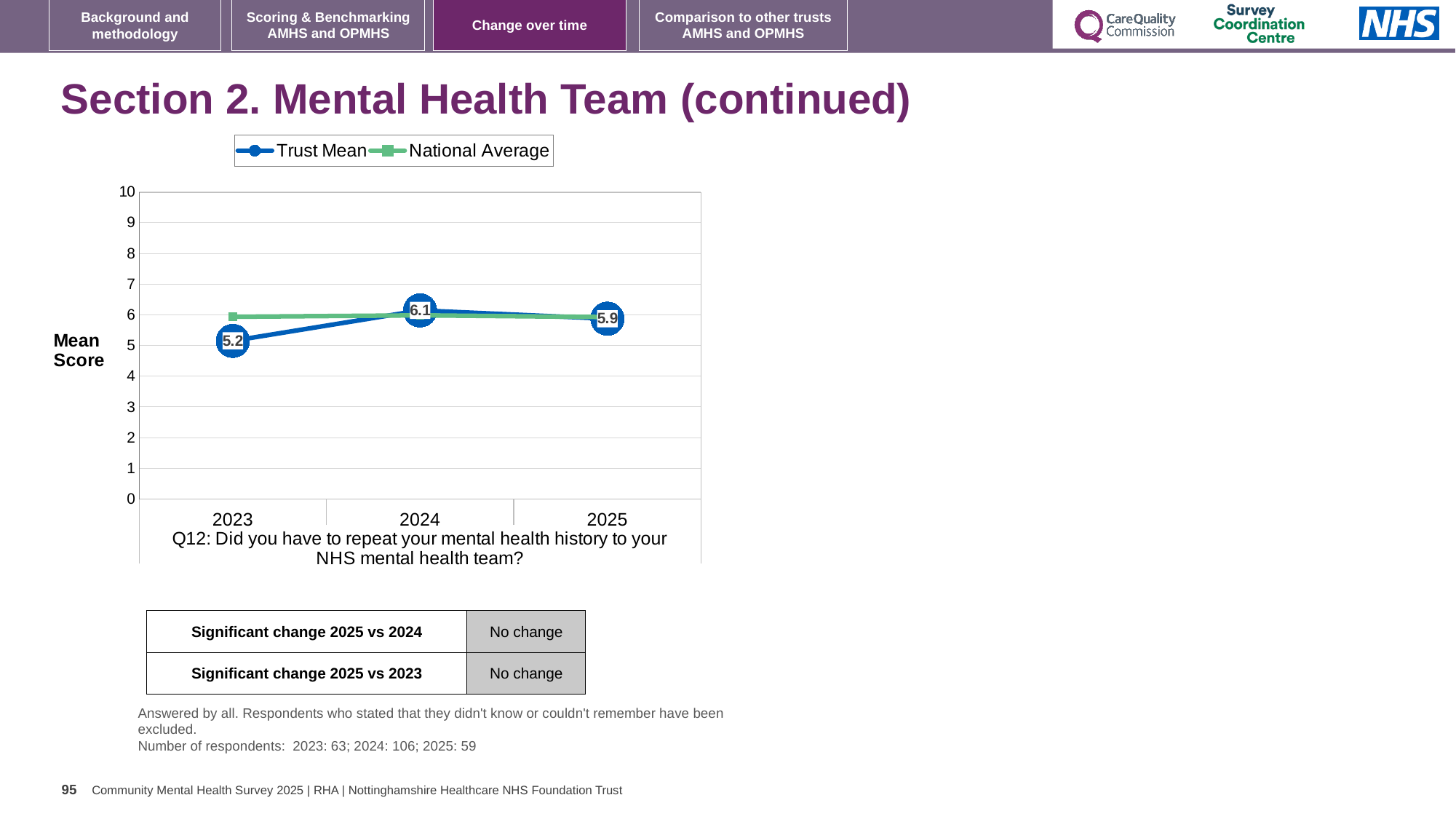
In which year is the Trust Mean highest? 2024 Is the National Average value for 2023 greater or less than 5? greater Does the Trust Mean rise or fall from 2023 to 2024? Rise How many years are plotted on the x axis? 3 What kind of chart is shown on the slide? Line chart What is the Trust Mean value for 2023? 5.2 In which year is the Trust Mean lowest? 2023 What is the Trust Mean value for 2024? 6.1 What is the Trust Mean value for 2025? 5.9 Which is larger, the Trust Mean for 2023 or for 2025? 2025 How many series does the legend list? 2 What is the difference between the Trust Mean in 2024 and in 2023? 0.9